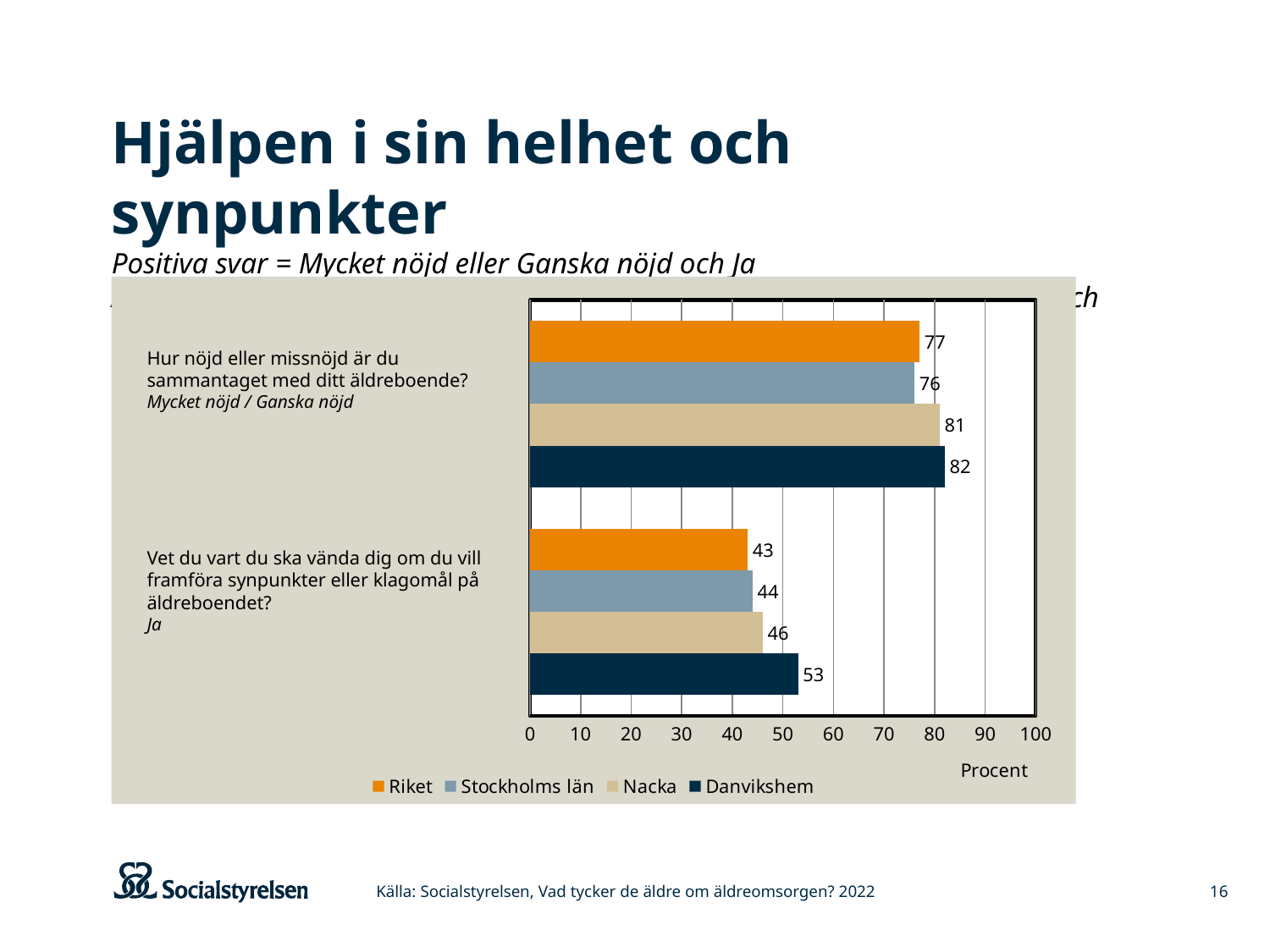
Which series has the highest value on the question "Vet du vart du ska vända dig om du vill framföra synpunkter eller klagomål på äldreboendet?"? Danvikshem What is the value for Danvikshem on the question "Hur nöjd eller missnöjd är du sammantaget med ditt äldreboende?"? 82 What is the difference between Nacka and Stockholms län on the question "Hur nöjd eller missnöjd är du sammantaget med ditt äldreboende?"? 5 Which series has the lowest value on the question "Hur nöjd eller missnöjd är du sammantaget med ditt äldreboende?"? Stockholms län What is the value for Nacka on the question "Hur nöjd eller missnöjd är du sammantaget med ditt äldreboende?"? 81 What is the value for Stockholms län on the question "Vet du vart du ska vända dig om du vill framföra synpunkter eller klagomål på äldreboendet?"? 44 What is the difference between Danvikshem and Riket on the question "Vet du vart du ska vända dig om du vill framföra synpunkter eller klagomål på äldreboendet?"? 10 What is the value for Riket on the question "Vet du vart du ska vända dig om du vill framföra synpunkter eller klagomål på äldreboendet?"? 43 Which is larger on the question "Vet du vart du ska vända dig om du vill framföra synpunkter eller klagomål på äldreboendet?": Nacka or Danvikshem? Danvikshem What unit is shown on the x axis of the chart? Procent How many series does the legend list? 4 What kind of chart is shown on the slide? Bar chart